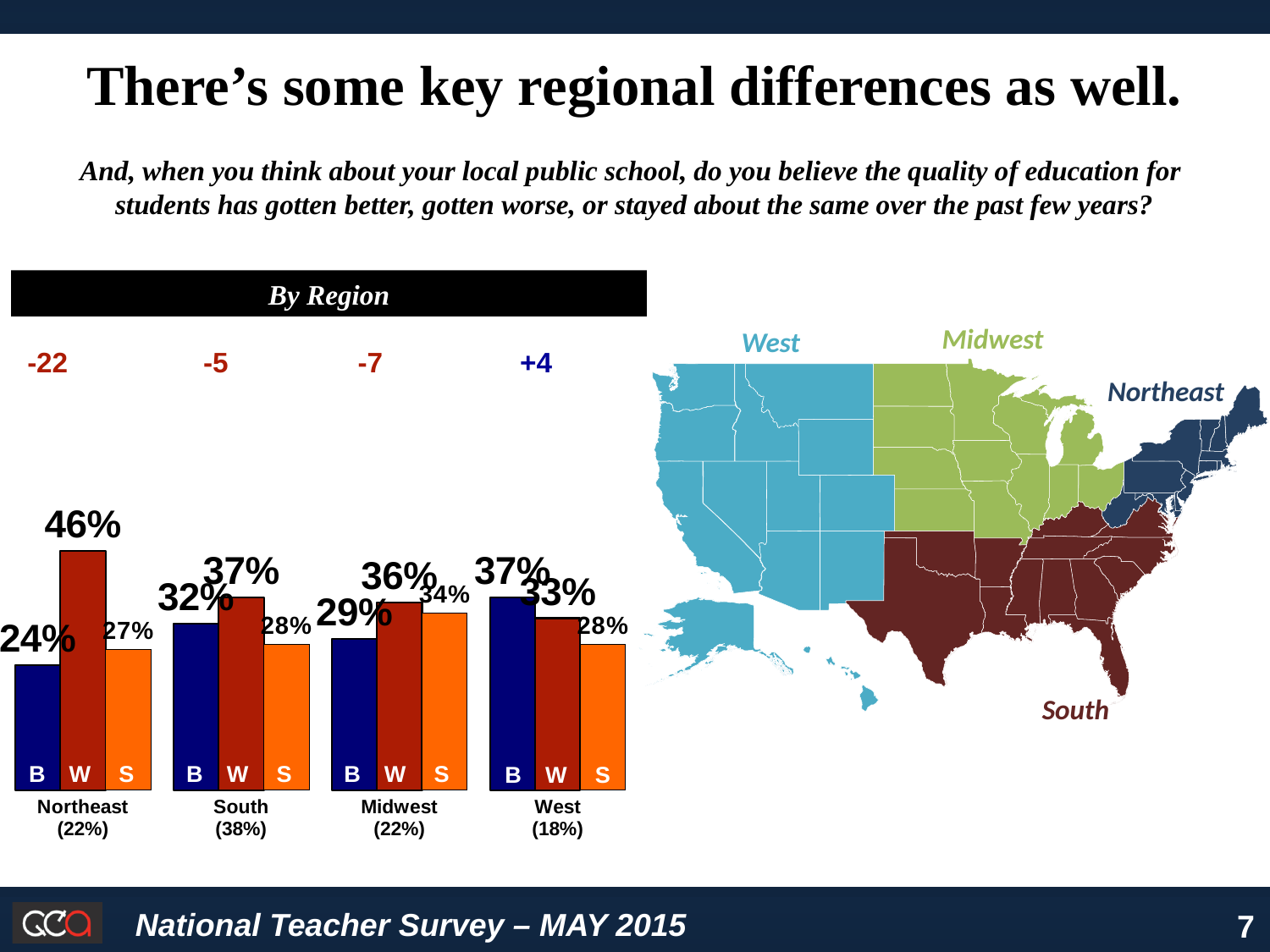
In the By Region chart, what is the value of the S bar for Midwest? 34% In the By Region chart, which region has the lowest B bar? Northeast In the By Region chart, what net score is shown above the West group? +4 In the By Region chart, what is the value of the W bar for Northeast? 46% In the By Region chart, what is the value of the B bar for Northeast? 24% What kind of chart is the By Region chart? bar chart In the By Region chart, which region has the highest W bar? Northeast In the By Region chart, what share of the sample is the South region labelled with? 38% How many regions are shown in the By Region chart? 4 In the By Region chart, what is the difference between the W bar and the B bar for Northeast? 22 percentage points In the By Region chart, what is the value of the B bar for West? 37% In the By Region chart, is the B bar or the W bar larger for West? B